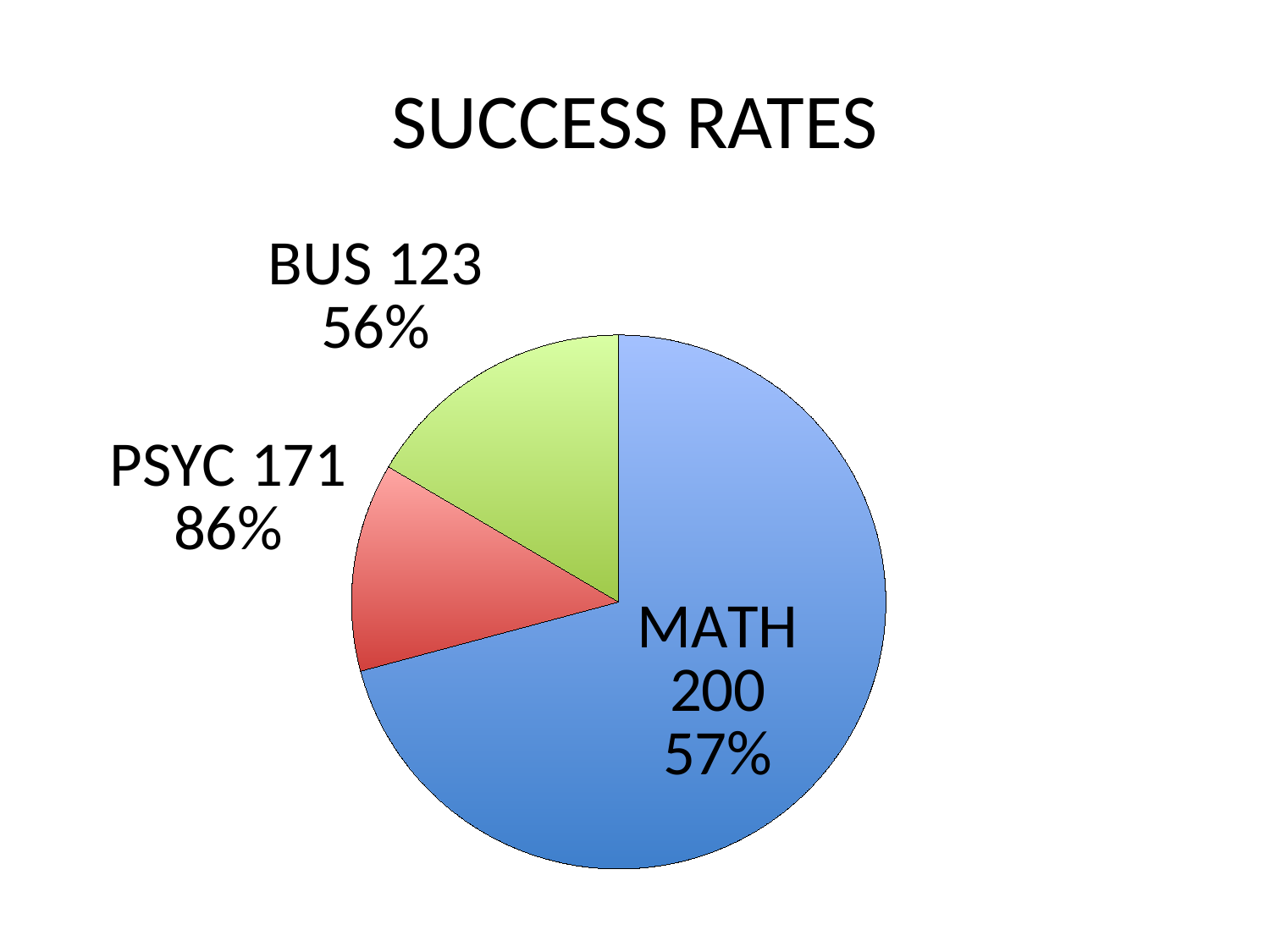
What success rate is shown for BUS 123? 56% Which colour is the MATH 200 slice? blue How many slices does the pie chart have? 3 What success rate is shown for PSYC 171? 86% Which course has the lowest success rate printed on the chart? BUS 123 What is the difference between the success rates of PSYC 171 and BUS 123? 30% What is the title of the chart? SUCCESS RATES Which has the higher success rate, MATH 200 or PSYC 171? PSYC 171 What kind of chart is shown on the slide? pie chart What is the difference between the success rates of PSYC 171 and MATH 200? 29% What success rate is shown for MATH 200? 57% Which course has the highest success rate printed on the chart? PSYC 171